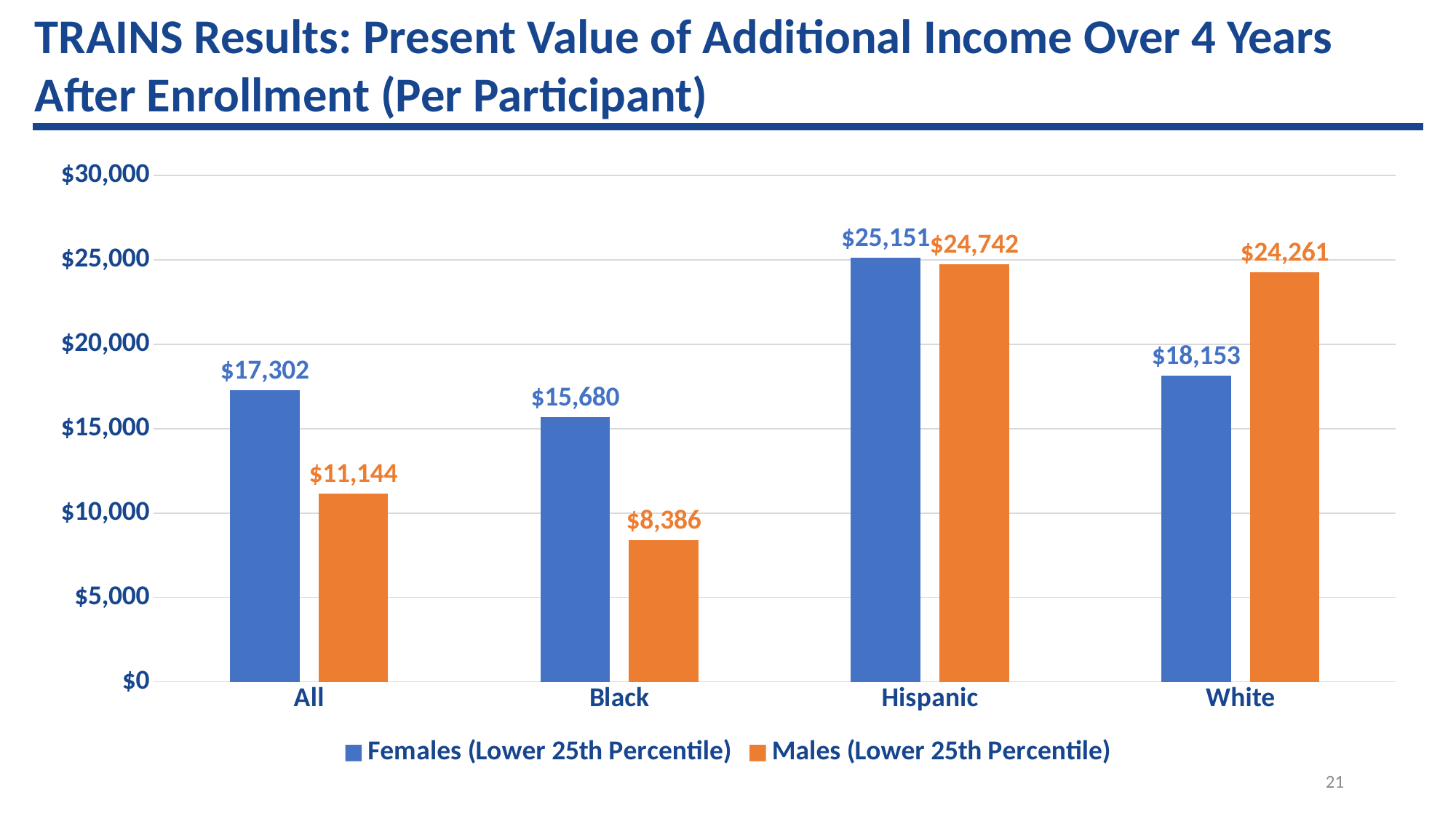
Is the value for Females (Lower 25th Percentile) in the White category greater or less than $20,000? less Which category has the highest value for Males (Lower 25th Percentile)? Hispanic What is the value for Males (Lower 25th Percentile) in the All category? $11,144 Which is larger in the White category: the Females value or the Males value? Males (Lower 25th Percentile) What colour represents the Males (Lower 25th Percentile) series? orange What is the difference between the Females and Males values in the All category? $6,158 Which category has the lowest value for Females (Lower 25th Percentile)? Black How many series does the legend list? 2 What kind of chart is shown on the slide? bar chart How many categories are shown on the x axis? 4 What is the value for Males (Lower 25th Percentile) in the Black category? $8,386 What is the value for Females (Lower 25th Percentile) in the Hispanic category? $25,151